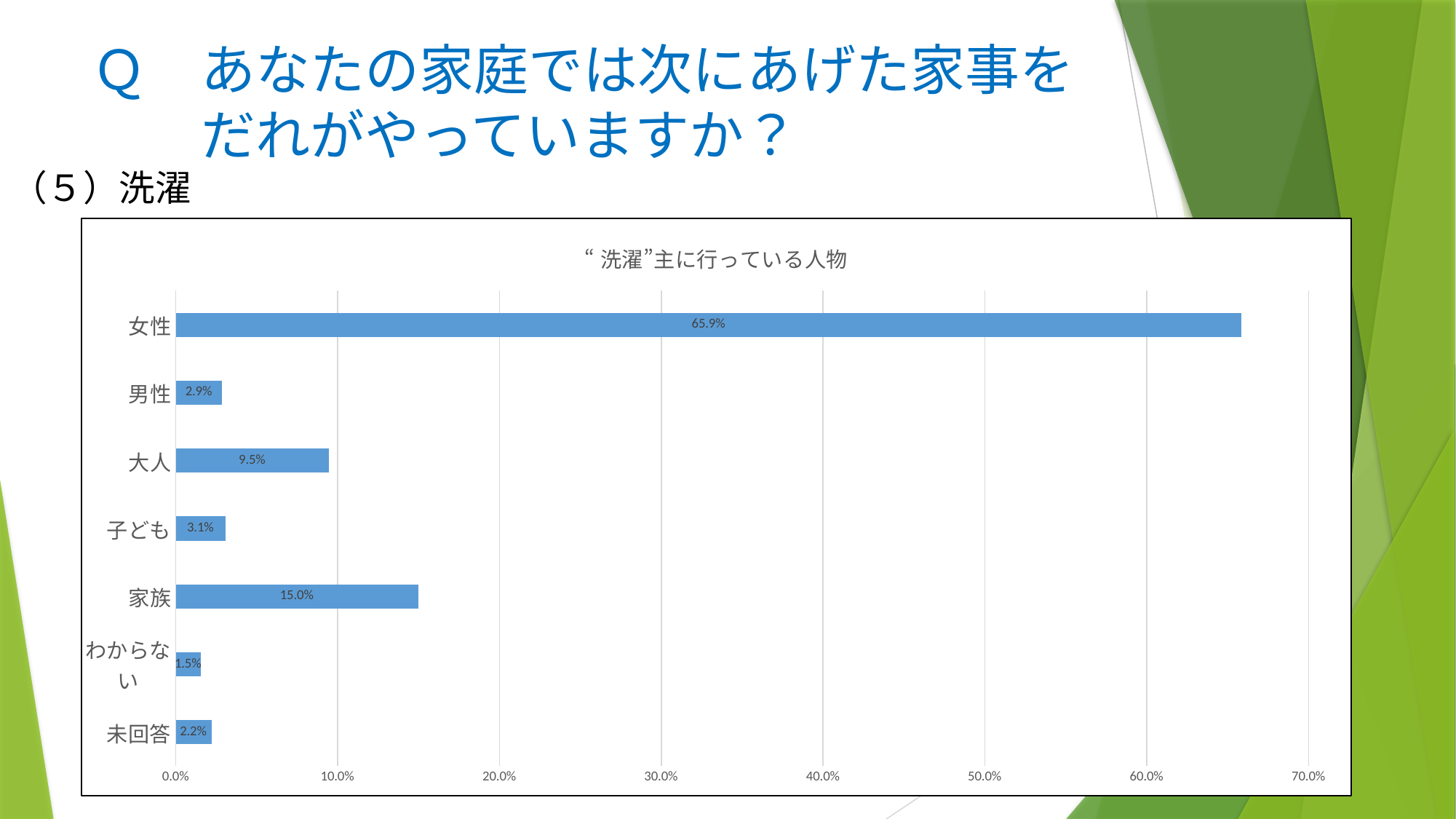
What is the difference between the values for 女性 and 家族? 50.9% What is the value for 家族? 15.0% How many categories are shown in the chart? 7 Which category has the lowest value? わからない What is the title of the chart? “ 洗濯”主に行っている人物 What kind of chart is shown on the slide? bar chart What is the value for 女性? 65.9% Which category has the highest value? 女性 What is the value for 大人? 9.5% Is the value for 女性 greater or less than 60.0%? greater Which is larger, the value for 男性 or the value for 子ども? 子ども What is the value for わからない? 1.5%